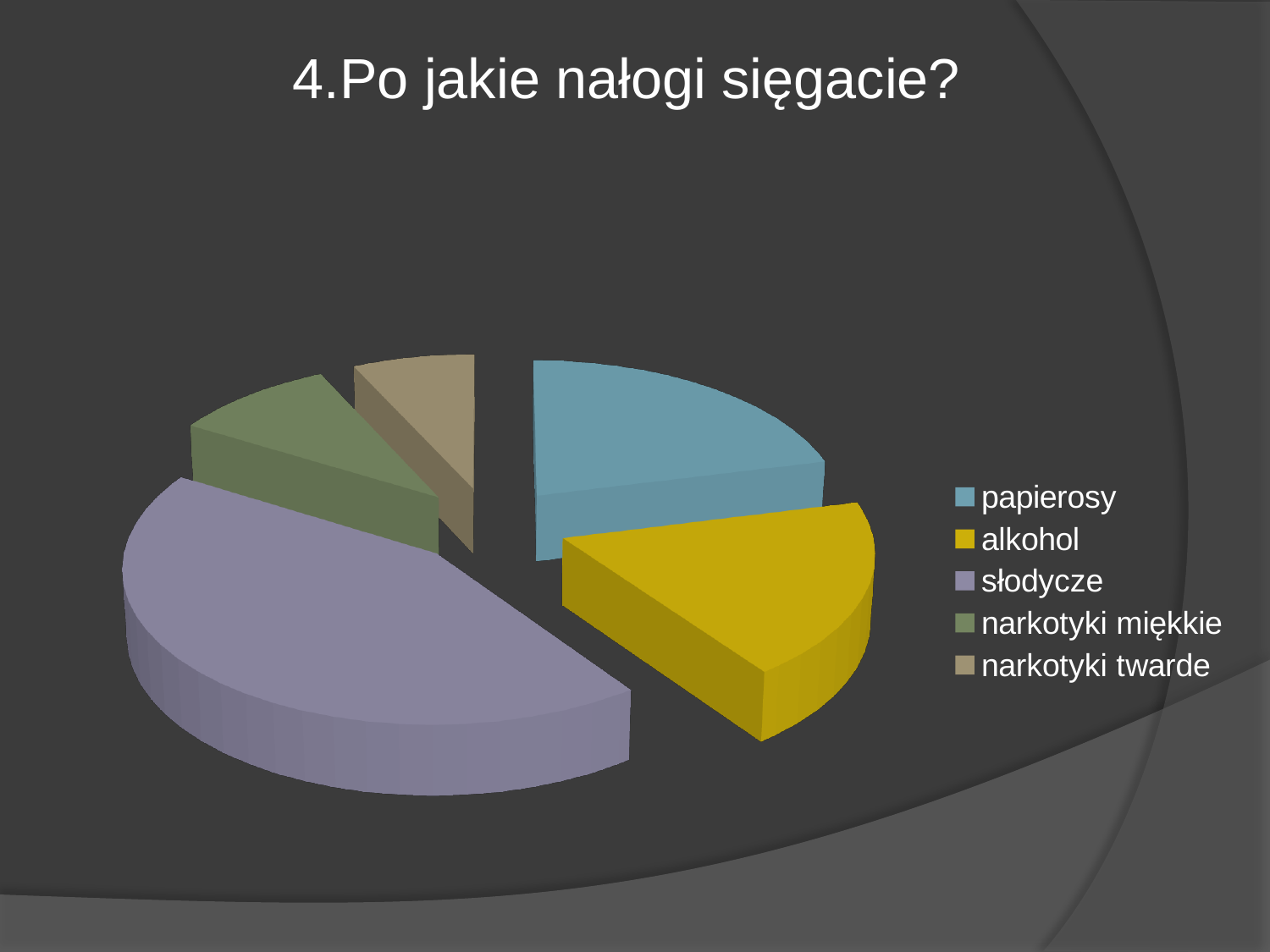
Which slice is larger, narkotyki miękkie or narkotyki twarde? narkotyki miękkie What is the title of the slide containing the pie chart? 4.Po jakie nałogi sięgacie? Which category is shown in yellow in the pie chart? alkohol Which slice is larger, słodycze or alkohol? słodycze Which slice is larger, papierosy or narkotyki twarde? papierosy How many categories does the pie chart show? 5 Which category has the largest slice of the pie? słodycze What kind of chart is shown on the slide? pie chart Which category has the smallest slice of the pie? narkotyki twarde